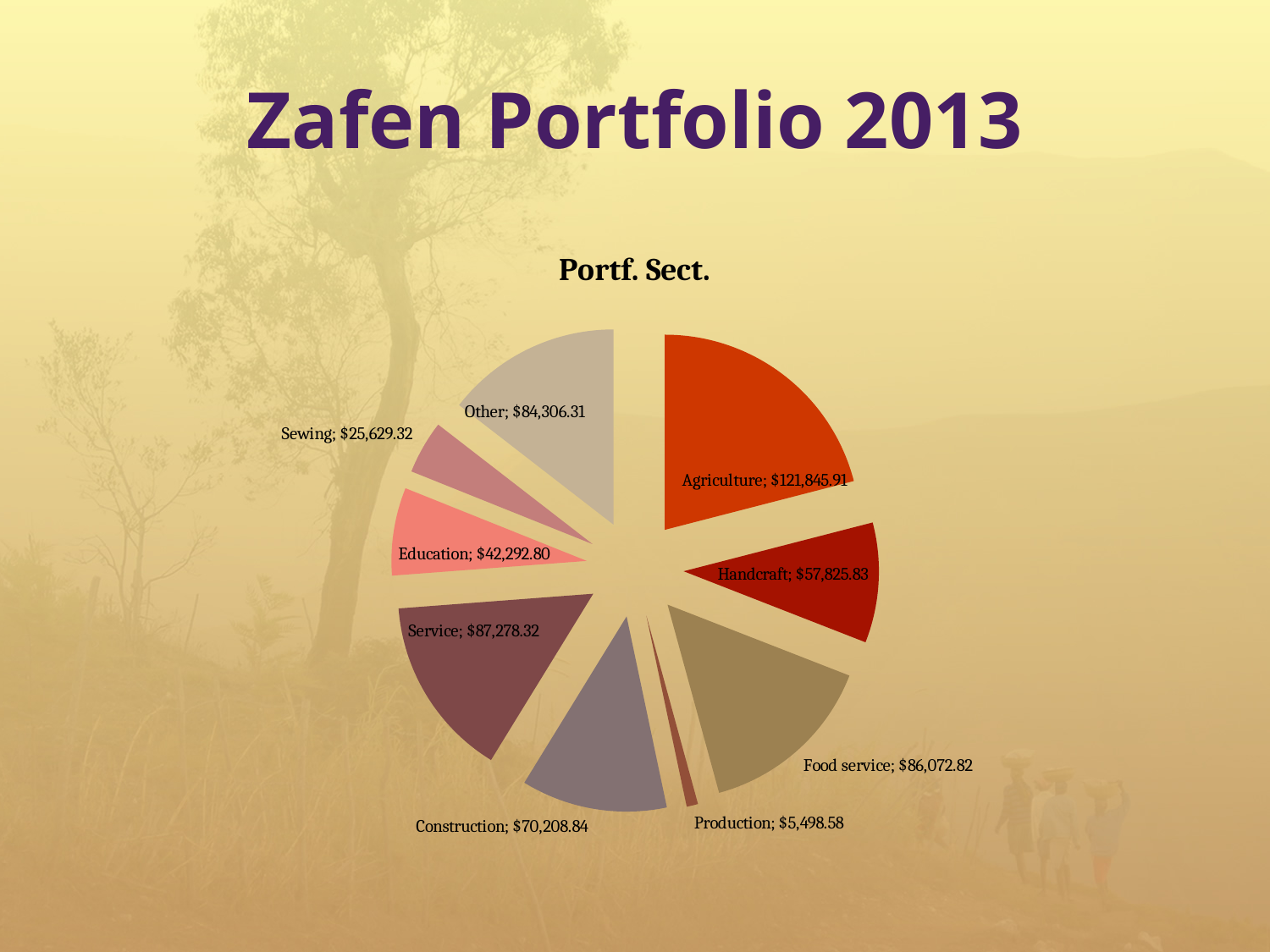
What is the value for Agriculture? $121,845.91 What is the value for Sewing? $25,629.32 Which sector has the smallest value? Production What is the value for Other? $84,306.31 What is the title of the chart? Portf. Sect. What type of chart is shown on the slide? Pie chart Which sector has the largest value? Agriculture Which is larger, Service or Food service? Service What is the value for Construction? $70,208.84 What is the difference between the Construction and Sewing values? $44,579.52 How many sectors (slices) does the pie chart show? 9 What is the difference between the Agriculture and Handcraft values? $64,020.08